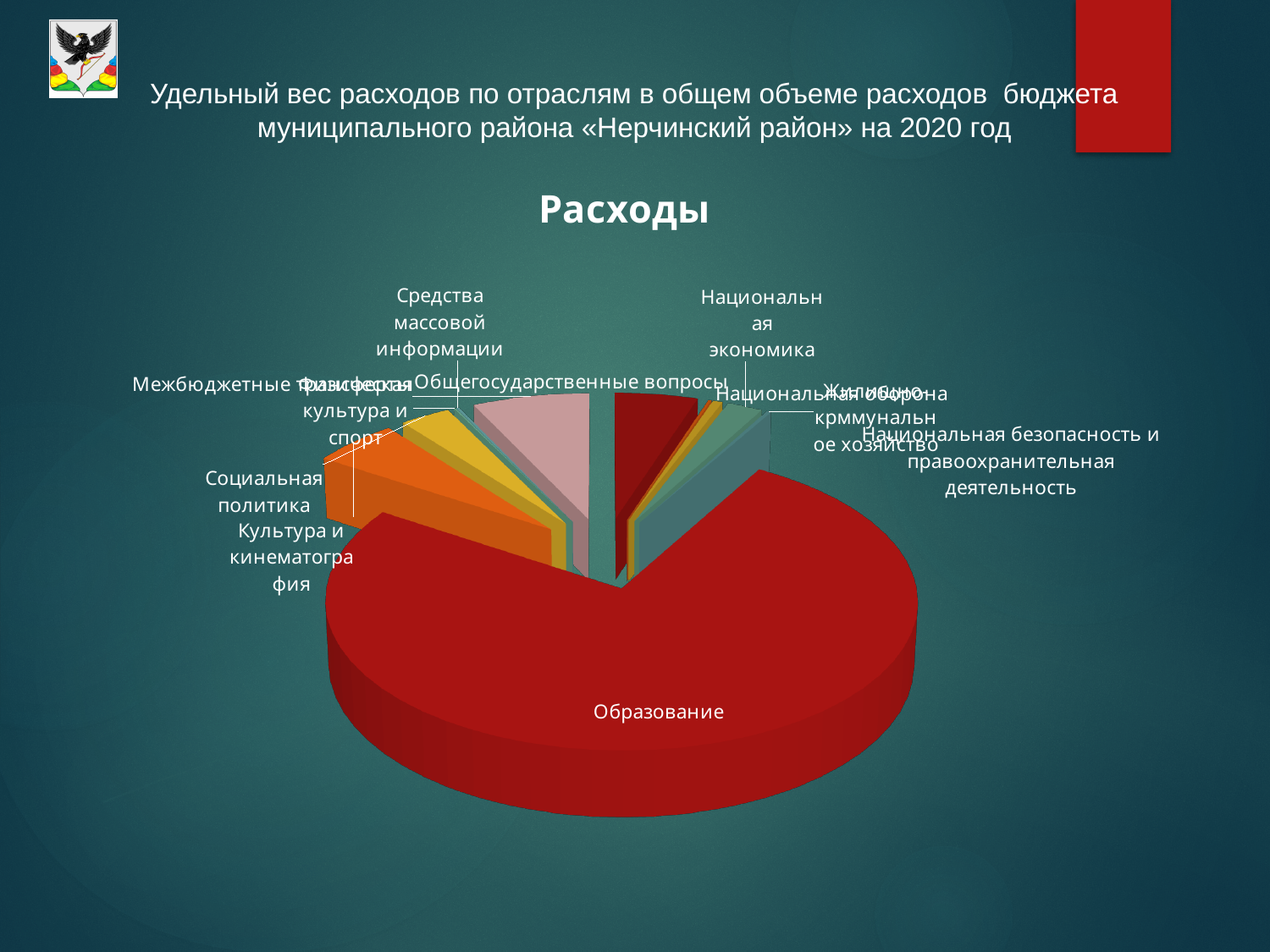
What colour is the slice for Образование? red What is the title of the chart? Расходы Which is larger: the slice for Средства массовой информации or the slice for Образование? Образование Which category has the largest share of the pie? Образование What kind of chart is shown on the slide? pie chart Which is larger: the slice for Образование or the slice for Общегосударственные вопросы? Образование Which is larger: the slice for Образование or the slice for Социальная политика? Образование How many categories (slices) are labelled on the pie chart? 11